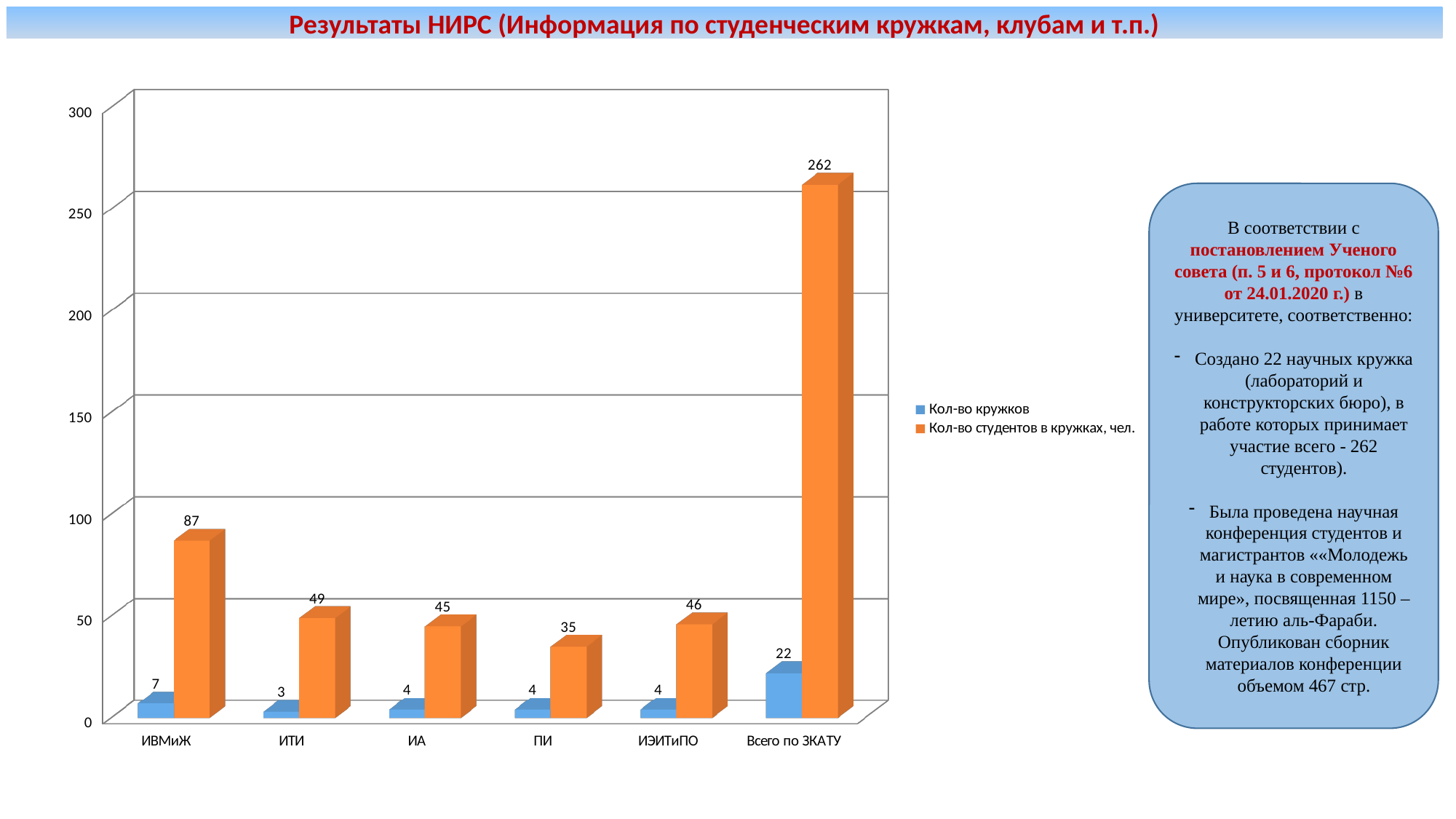
How many categories are shown on the x axis? 6 Among the individual institutes (excluding Всего по ЗКАТУ), which category has the lowest value for 'Кол-во студентов в кружках, чел.'? ПИ What is the value of 'Кол-во кружков' for ИТИ? 3 What colour are the bars for 'Кол-во студентов в кружках, чел.'? orange What is the value of 'Кол-во студентов в кружках, чел.' for ИВМиЖ? 87 How many series does the legend list? 2 Which category has the highest value for 'Кол-во кружков'? Всего по ЗКАТУ What kind of chart is shown on the slide? bar chart Which is larger: the 'Кол-во студентов в кружках, чел.' value for ИЭИТиПО or for ИА? ИЭИТиПО What is the difference between the 'Кол-во студентов в кружках, чел.' values for ИТИ and ИА? 4 What is the value of 'Кол-во студентов в кружках, чел.' for Всего по ЗКАТУ? 262 Is the value of 'Кол-во студентов в кружках, чел.' for Всего по ЗКАТУ greater or less than 250? greater